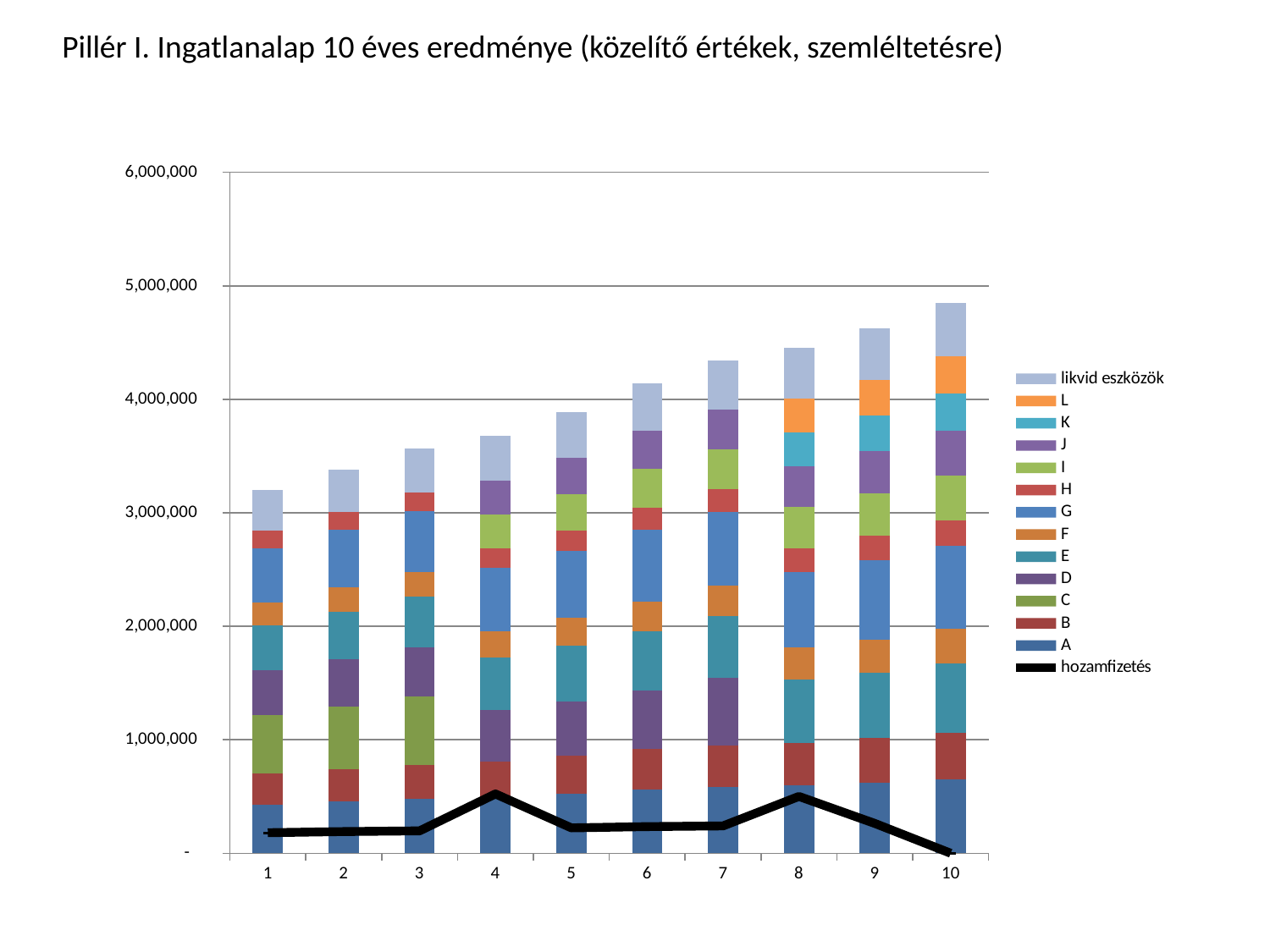
Is the total of the stacked bar for category 10 greater or less than 4,000,000? greater How many categories are shown on the x axis? 10 Is the total of the stacked bar for category 4 greater or less than 4,000,000? less Which category has the tallest stacked bar? 10 At which category does the hozamfizetés line reach its lowest value? 10 Do the stacked bar totals rise or fall from category 1 to category 10? rise How many series does the legend list? 14 What is the title of the chart? Pillér I. Ingatlanalap 10 éves eredménye (közelítő értékek, szemléltetésre) Which category has the shortest stacked bar? 1 Is the total of the stacked bar for category 1 greater or less than 3,000,000? greater What kind of chart is shown on the slide? stacked bar chart with a line Which stacked bar is taller, category 8 or category 3? 8